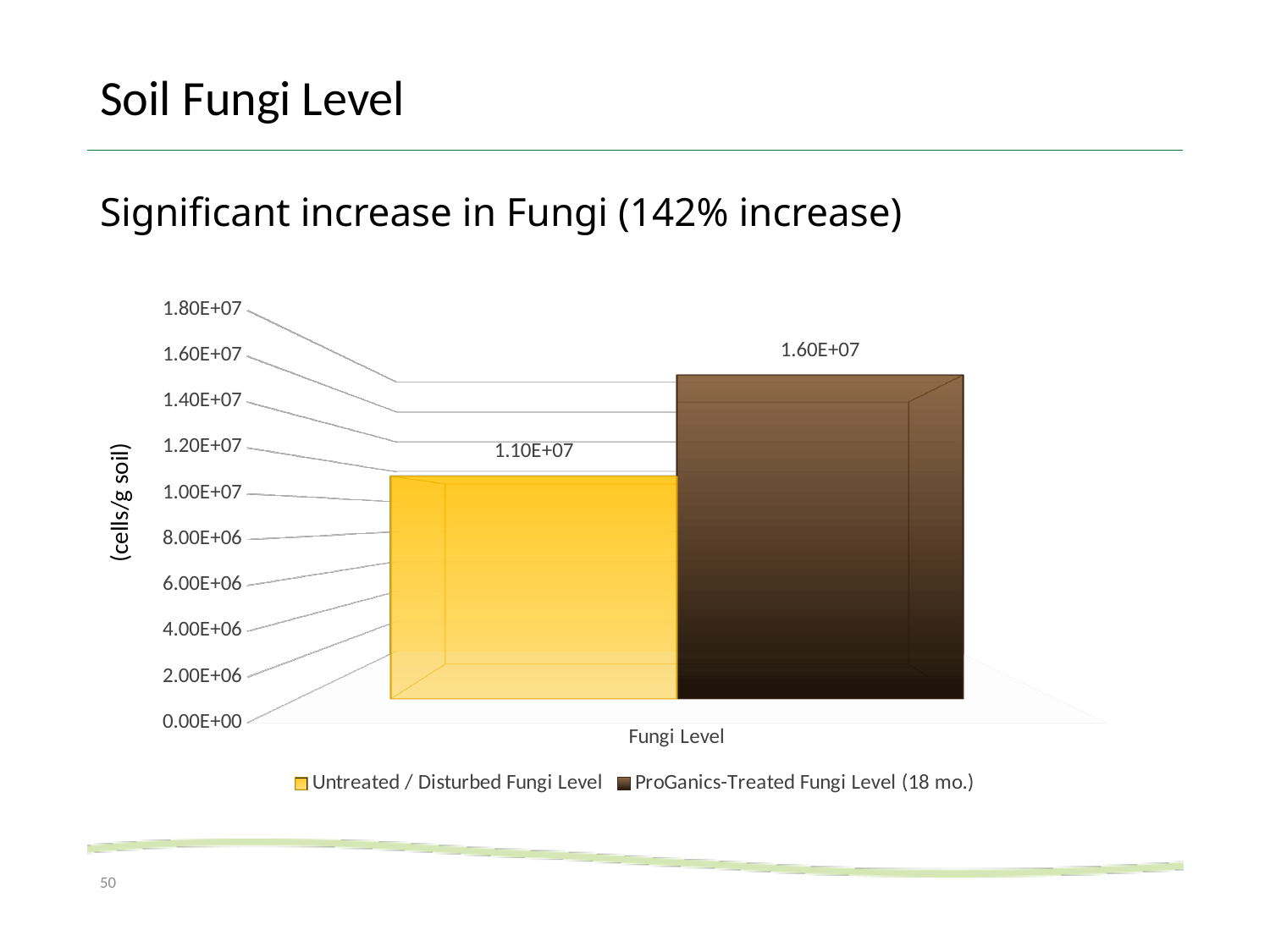
What is the value for the Untreated / Disturbed Fungi Level series? 1.10E+07 Is the value for the Untreated / Disturbed Fungi Level greater or less than 1.20E+07? less Is the value for the ProGanics-Treated Fungi Level (18 mo.) greater or less than 1.40E+07? greater What is the label of the vertical axis? (cells/g soil) Which series has the higher value? ProGanics-Treated Fungi Level (18 mo.) Is the value for the Untreated / Disturbed Fungi Level larger or smaller than the value for the ProGanics-Treated Fungi Level (18 mo.)? smaller Which series has the lower value? Untreated / Disturbed Fungi Level What is the value for the ProGanics-Treated Fungi Level (18 mo.) series? 1.60E+07 How many series does the legend list? 2 What kind of chart is shown on the slide? bar chart What is the difference between the ProGanics-Treated Fungi Level (18 mo.) value and the Untreated / Disturbed Fungi Level value? 5.00E+06 How many categories are shown on the x axis? 1